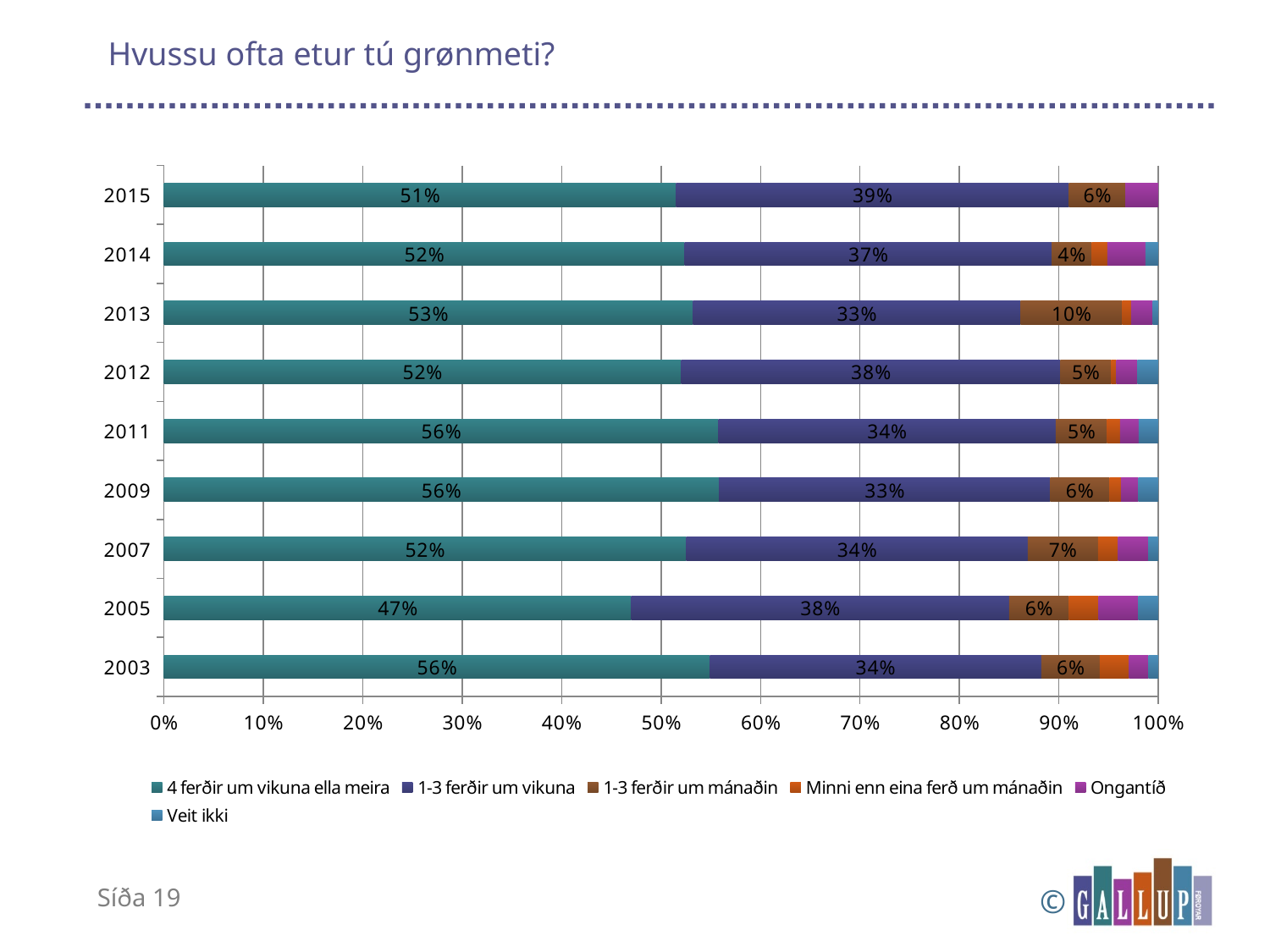
Which year has the larger value for "1-3 ferðir um vikuna", 2013 or 2014? 2014 How many series does the legend list? 6 What is the value for "1-3 ferðir um vikuna" in 2014? 37% Which year has the highest value for "1-3 ferðir um vikuna"? 2015 Which year has the highest value for "1-3 ferðir um mánaðin"? 2013 Which year has the lowest value for "4 ferðir um vikuna ella meira"? 2005 What is the difference in percentage points between the "4 ferðir um vikuna ella meira" values for 2015 and 2005? 4 percentage points How many years are shown on the chart? 9 What is the value for "4 ferðir um vikuna ella meira" in 2005? 47% What is the value for "1-3 ferðir um mánaðin" in 2013? 10% What kind of chart is shown on the slide? Stacked bar chart What percentage of respondents in 2015 answered "4 ferðir um vikuna ella meira"? 51%